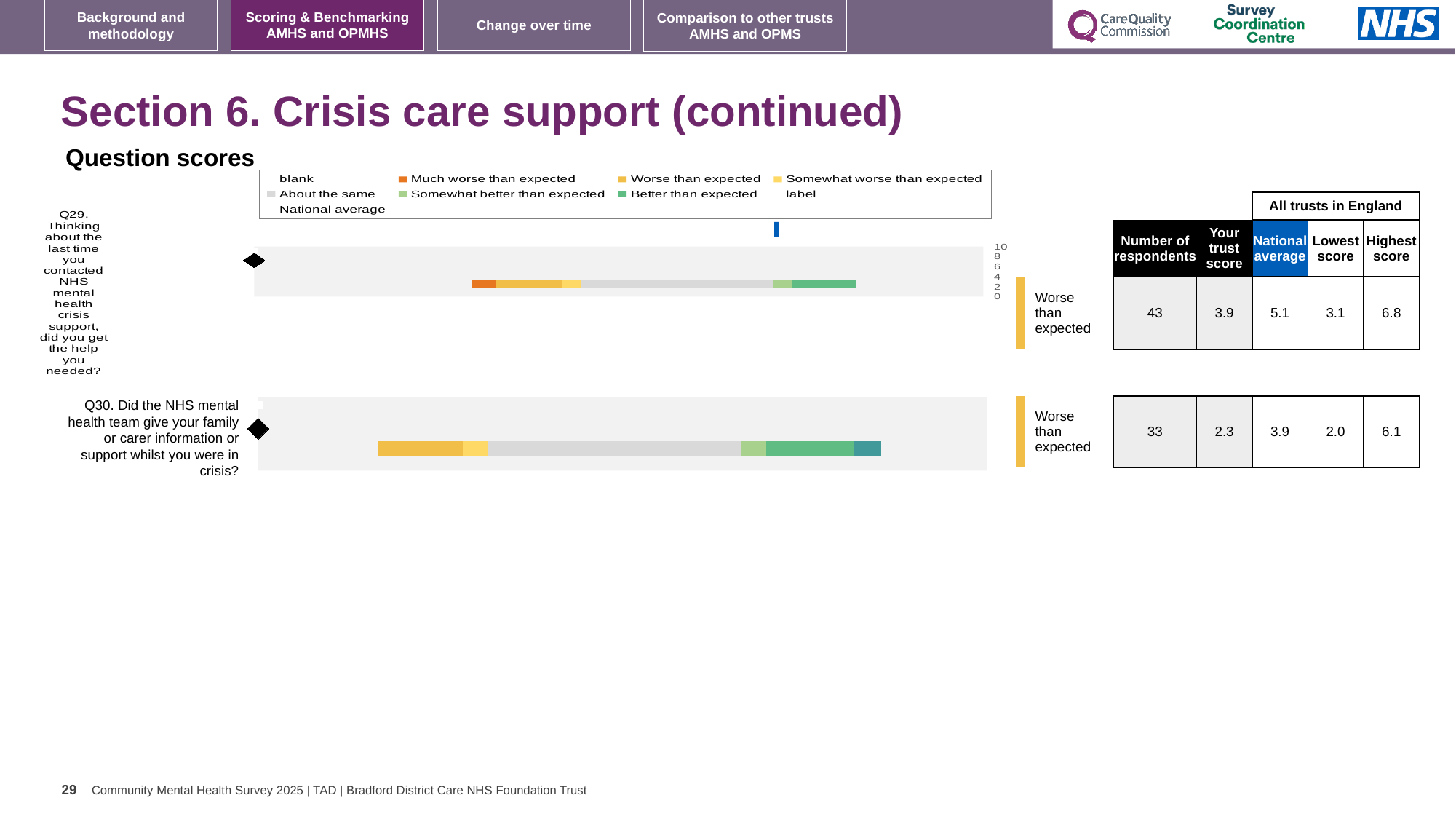
For the Q30 chart, how many respondents are there? 33 How many questions are plotted in the question scores charts on this slide? 2 For the Q29 chart, what is the trust's score shown in the table? 3.9 For the Q30 chart, what is the trust's score shown in the table? 2.3 For the Q29 chart, what is the highest score among all trusts in England? 6.8 What kind of chart is used to show the question scores for Q29 and Q30? bar chart For the Q29 chart, what is the national average score? 5.1 What benchmark category label is shown next to the Q29 chart? Worse than expected Which question has the higher trust score, Q29 or Q30? Q29 For Q29, what is the difference between the national average and the trust's score? 1.2 For Q30, what is the difference between the highest score and the lowest score among all trusts in England? 4.1 In the chart legend, what colour represents 'Much worse than expected'? orange